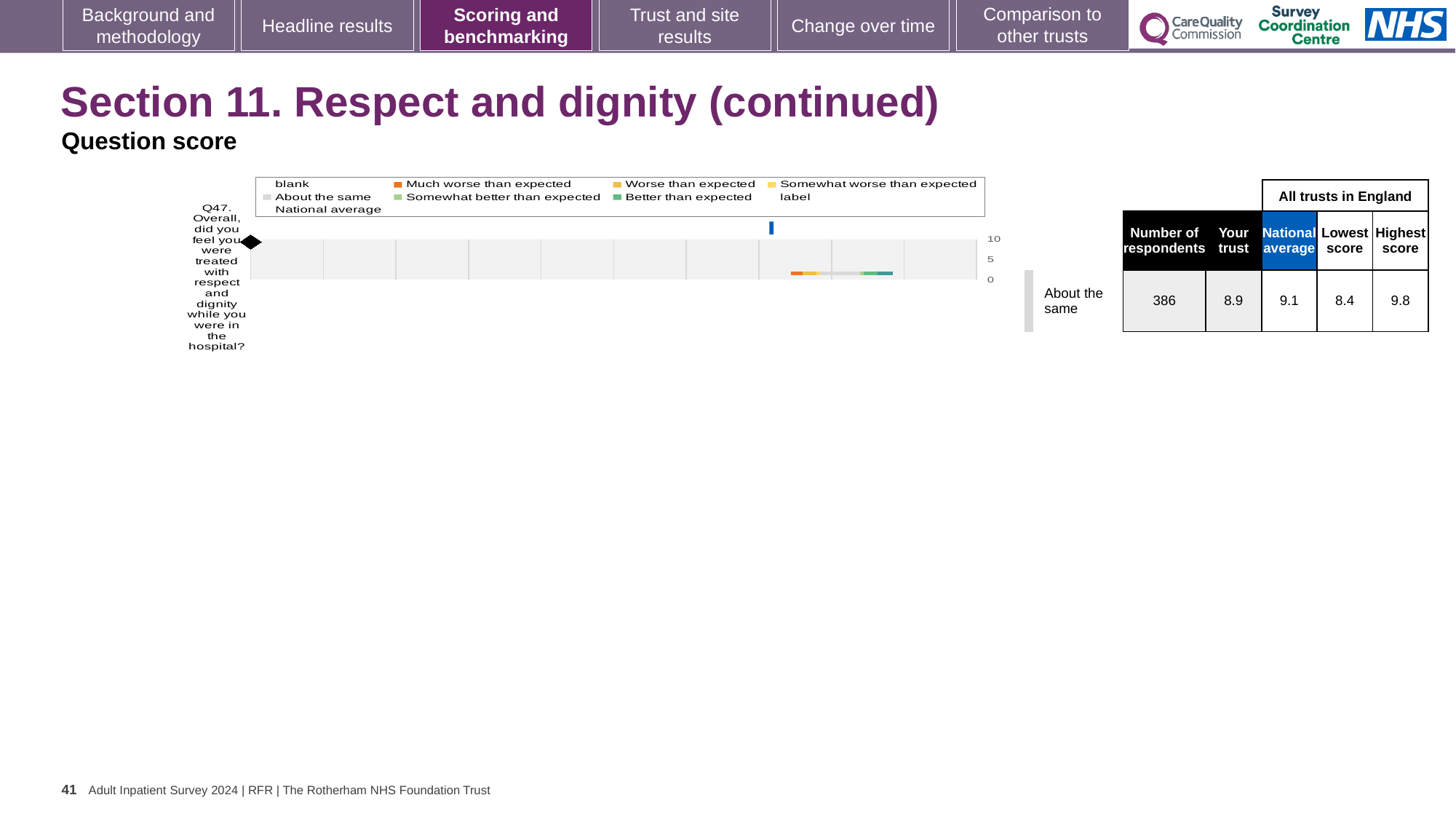
What is the highest value shown on the chart's numeric axis? 10 What benchmark category is the trust's result for Q47 assigned to? About the same What is the difference between the national average and the 'Your trust' score for Q47? 0.2 What is the difference between the highest and lowest scores among all trusts in England for Q47? 1.4 How many respondents are listed for Q47? 386 What is the highest score among all trusts in England for Q47? 9.8 Which is larger for Q47, the 'Your trust' score or the national average? National average What kind of chart is shown on the slide? bar chart What is the 'Your trust' score for Q47? 8.9 What is the national average score for Q47? 9.1 What is the lowest score among all trusts in England for Q47? 8.4 Which survey question is plotted in the chart? Q47. Overall, did you feel you were treated with respect and dignity while you were in the hospital?